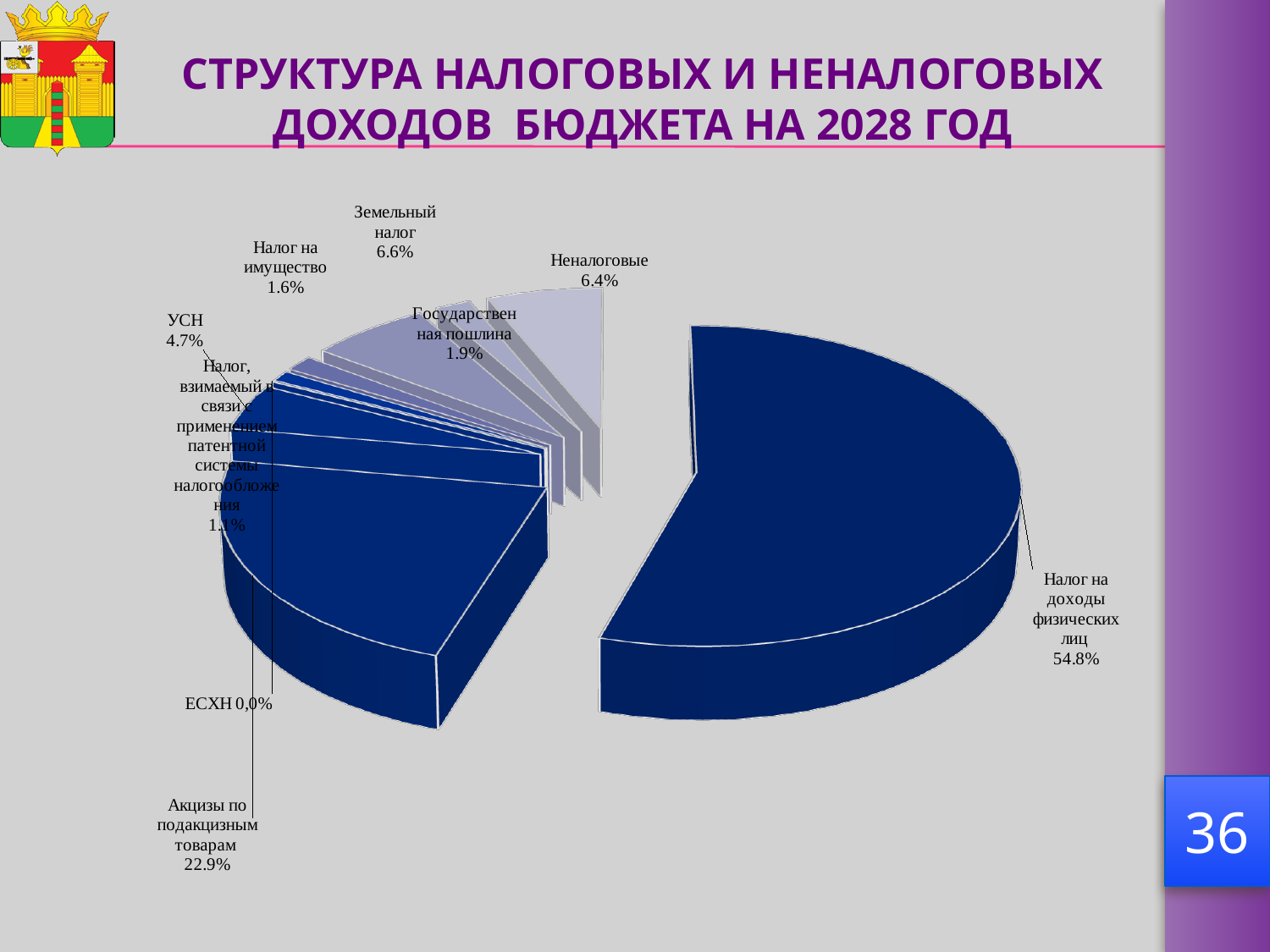
Which category has the largest share of the pie? Налог на доходы физических лиц What is the value shown for "Акцизы по подакцизным товарам"? 22.9% What is the difference between the shares of "Налог на доходы физических лиц" and "Акцизы по подакцизным товарам"? 31.9% How many categories are shown in the pie chart? 9 Which is larger, the share for "Налог на имущество" or the share for "УСН"? УСН What is the value shown for "Земельный налог"? 6.6% What is the value shown for "Государственная пошлина"? 1.9% What share of the pie does "Налог на доходы физических лиц" have? 54.8% What kind of chart is shown on the slide? Pie chart What is the value shown for "Неналоговые"? 6.4% What is the value shown for "УСН"? 4.7% Which category has the smallest share of the pie? ЕСХН